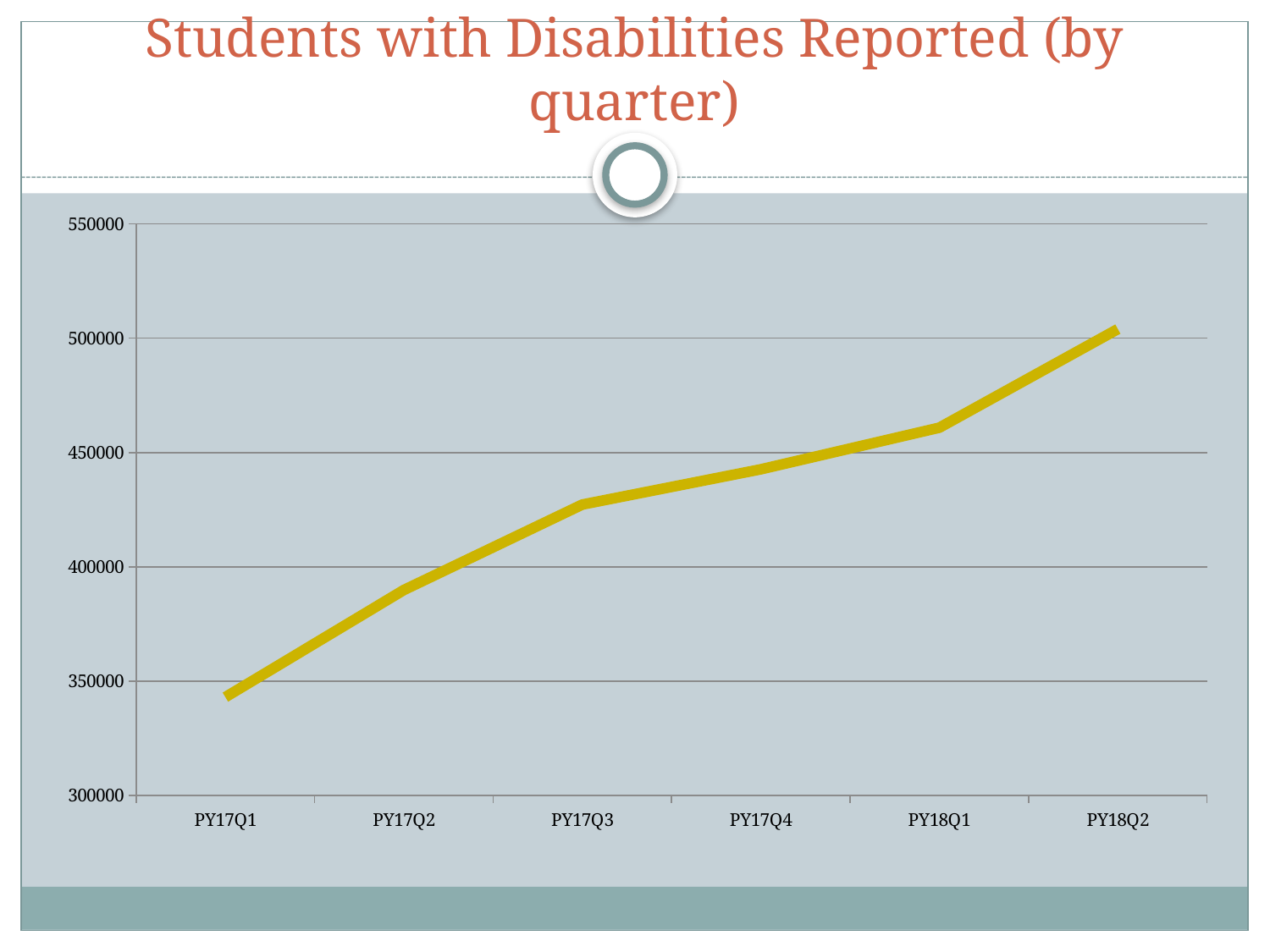
Is the value for PY18Q2 greater or less than 450000? greater Is the value for PY17Q2 greater or less than 400000? less Is the value for PY18Q1 greater or less than 450000? greater How many quarters are plotted on the x axis? 6 Which quarter has the highest number of students with disabilities reported? PY18Q2 What kind of chart is shown on the slide? line chart Which quarter has the lowest number of students with disabilities reported? PY17Q1 Do the values rise or fall from PY17Q1 to PY18Q2? rise Which is larger, the value for PY17Q2 or the value for PY17Q3? PY17Q3 What is the title of the chart? Students with Disabilities Reported (by quarter)